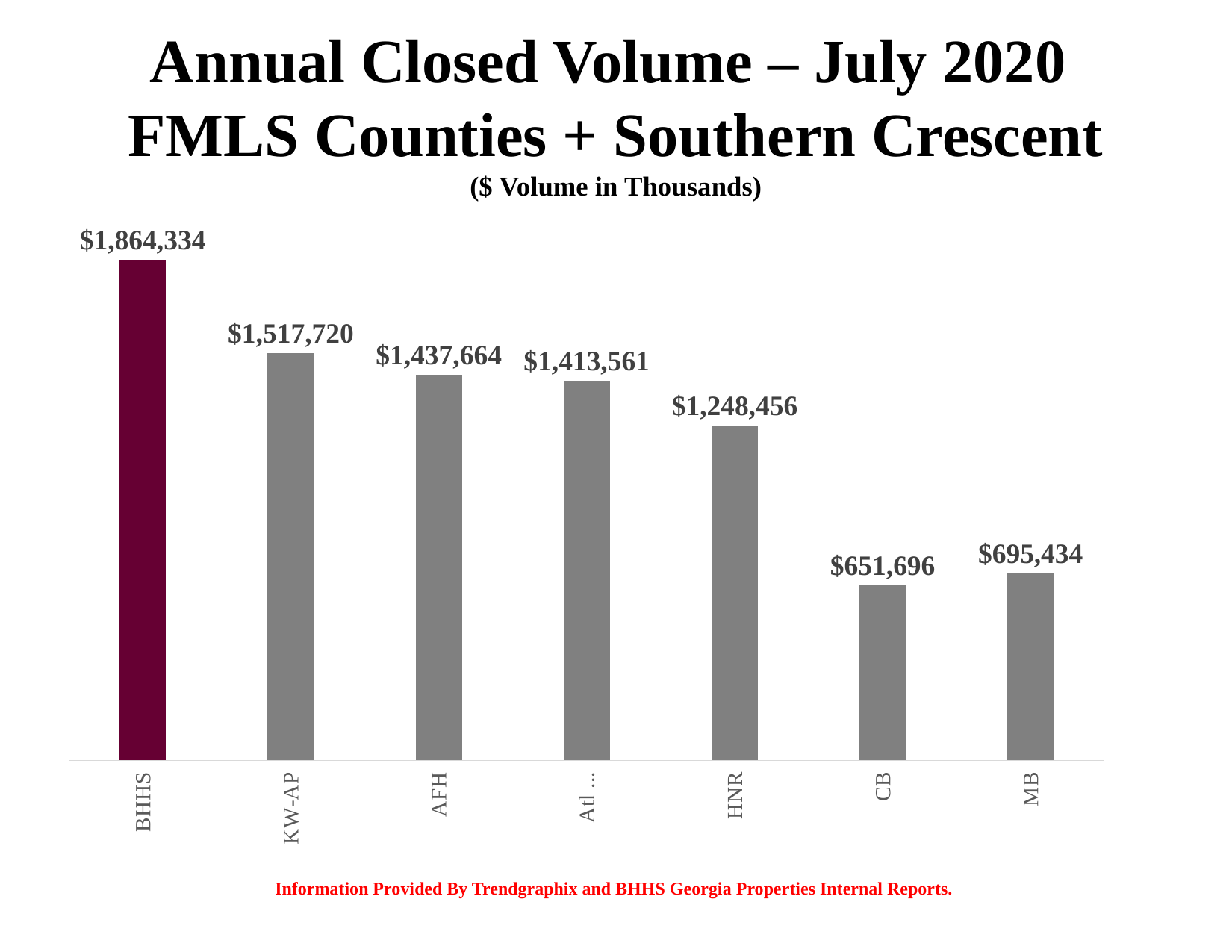
What is the annual closed volume for KW-AP? $1,517,720 How many companies are shown in the chart? 7 Which company has the highest annual closed volume? BHHS Which company has the lowest annual closed volume? CB What is the annual closed volume for MB? $695,434 What is the annual closed volume for HNR? $1,248,456 What kind of chart is shown on the slide? Bar chart Which has a larger annual closed volume, AFH or HNR? AFH What is the annual closed volume for BHHS? $1,864,334 What is the annual closed volume for CB? $651,696 What is the difference between the closed volume of BHHS and KW-AP? $346,614 What is the difference between the closed volume of MB and CB? $43,738